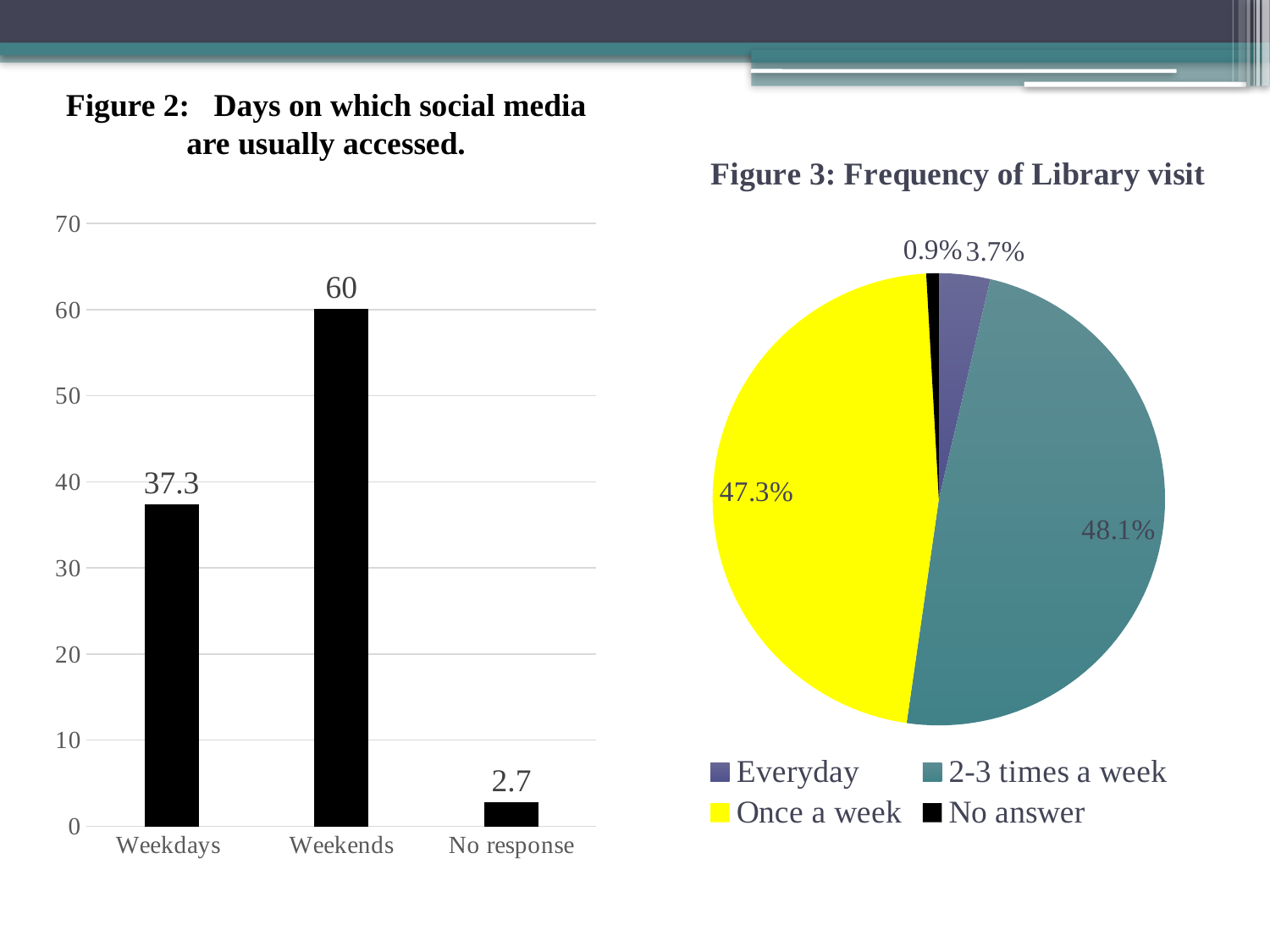
In Figure 3, which category has the smallest slice? No answer In Figure 2, which category has the lowest value? No response In Figure 2, what is the difference between the Weekends and Weekdays values? 22.7 In Figure 2, what is the value for Weekends? 60 In Figure 3, what share of the pie is Once a week? 47.3% In Figure 2, what is the value for Weekdays? 37.3 In Figure 3, which is larger, Everyday or No answer? Everyday In Figure 3, how many entries does the legend list? 4 In Figure 2, how many categories are shown on the x axis? 3 What kind of chart is Figure 2? Bar chart In Figure 3, what share of the pie is 2-3 times a week? 48.1% In Figure 3, what colour is the Once a week slice? Yellow